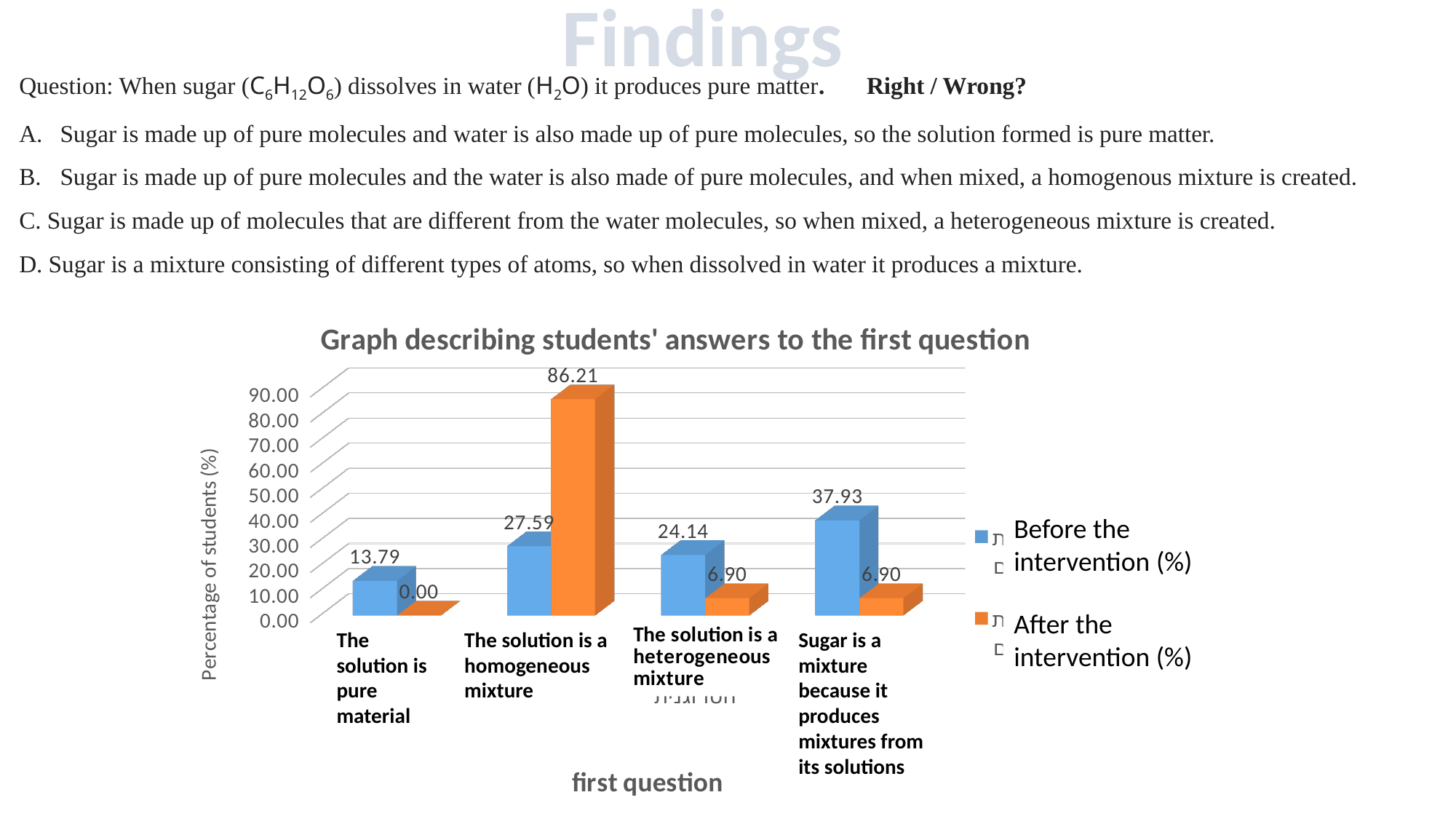
What is the value for 'The solution is a heterogeneous mixture' after the intervention? 6.90 For 'Sugar is a mixture because it produces mixtures from its solutions', which is larger: the value before or after the intervention? Before the intervention How many series does the legend list? 2 What is the value for 'The solution is pure material' before the intervention? 13.79 What does the y axis of the chart represent? Percentage of students (%) Which category has the highest value before the intervention? Sugar is a mixture because it produces mixtures from its solutions How many answer categories are shown on the x axis? 4 What is the difference between the after-intervention and before-intervention values for 'The solution is a homogeneous mixture'? 58.62 What type of chart is shown on the slide? Bar chart Which category has the lowest value after the intervention? The solution is pure material What is the value for 'The solution is a homogeneous mixture' after the intervention? 86.21 What is the title of the chart? Graph describing students' answers to the first question